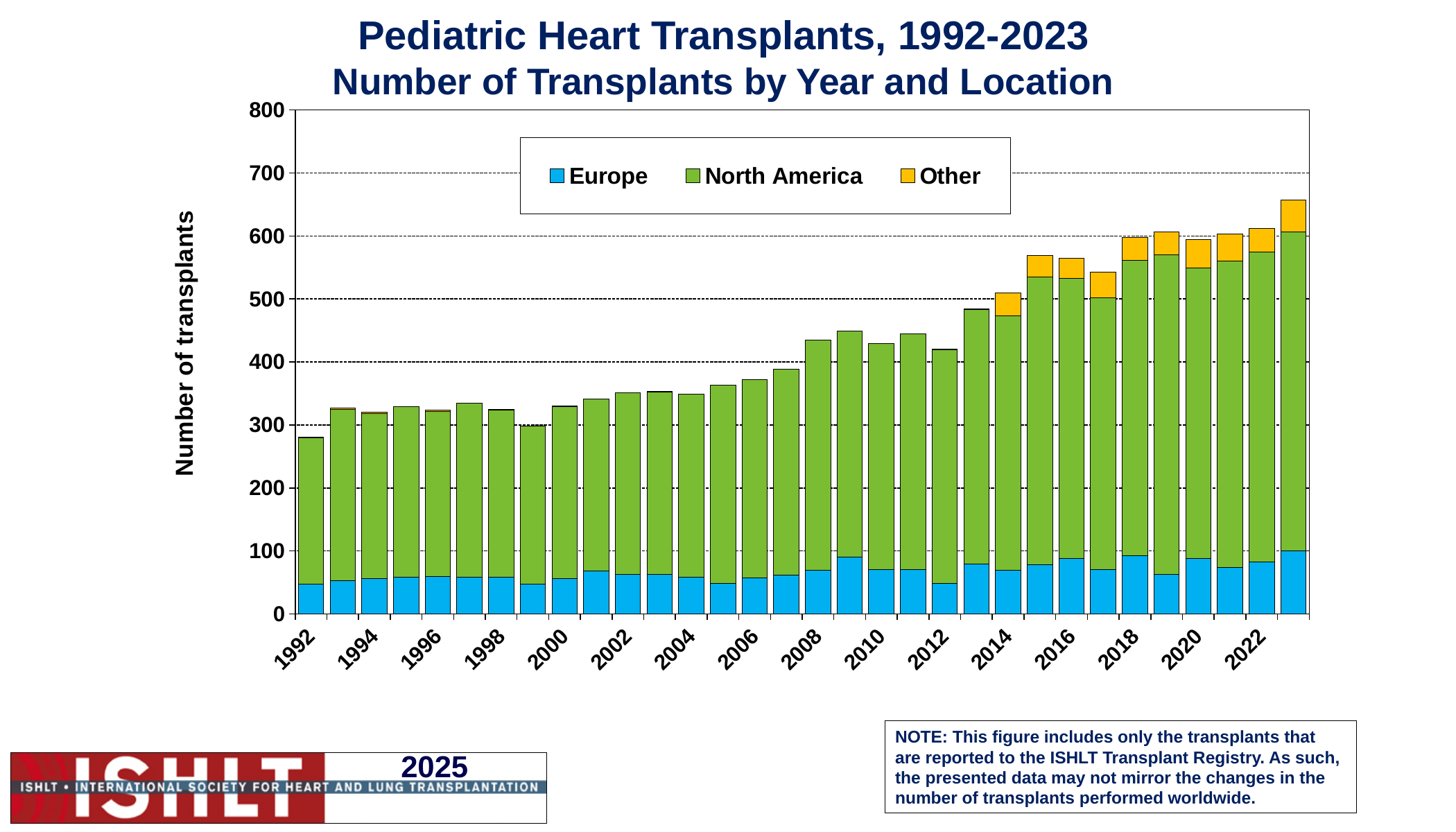
How many series does the legend list? 3 Which year has a larger total number of transplants, 2012 or 2013? 2013 Overall, do the total number of transplants rise or fall from 1992 to 2023? rise Which series are listed in the legend? Europe, North America, Other What kind of chart is shown on the slide? Stacked bar chart Which year has the highest total number of transplants? 2023 Is the total number of transplants in 2013 greater or less than 500? less Is the total number of transplants in 1992 greater or less than 300? less Is the total number of transplants in 2023 greater or less than 600? greater How many years (bars) are plotted on the x axis? 32 Which year has the lowest total number of transplants? 1992